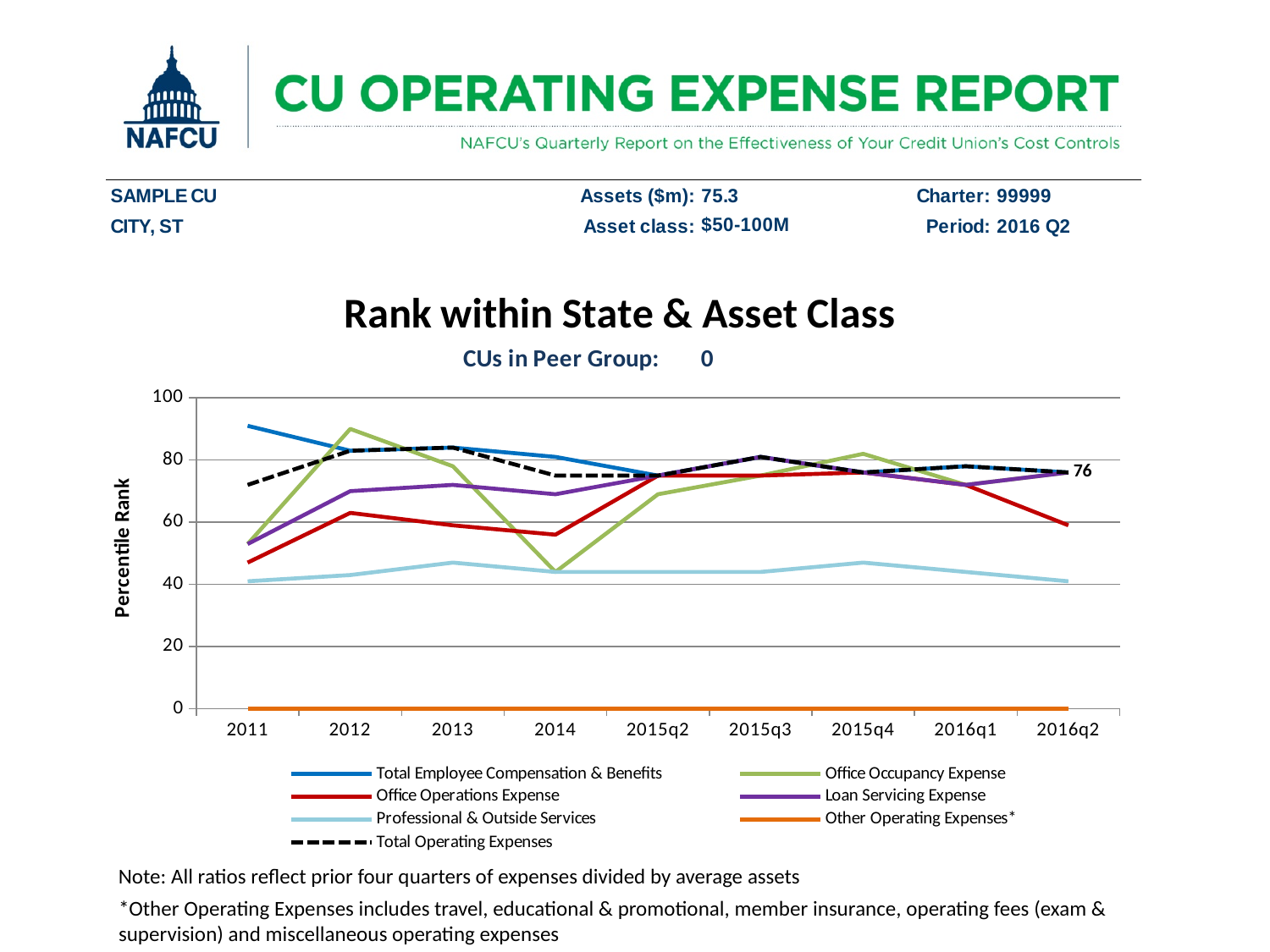
What is the percentile rank for Total Operating Expenses in 2016q2? 76 Is the value for Other Operating Expenses* in 2016q2 greater or less than 20? less Is the value for Office Occupancy Expense in 2014 greater or less than 60? less What kind of chart is shown on the slide? Line chart What is the label on the chart's vertical axis? Percentile Rank Which series has the lowest value in 2016q2? Other Operating Expenses* Is the value for Total Employee Compensation & Benefits in 2011 greater or less than 80? greater How many periods are shown along the x axis of the chart? 9 How many series does the chart's legend list? 7 Does the Total Employee Compensation & Benefits line rise or fall from 2011 to 2015q2? Fall In 2011, which is higher: Total Employee Compensation & Benefits or Professional & Outside Services? Total Employee Compensation & Benefits